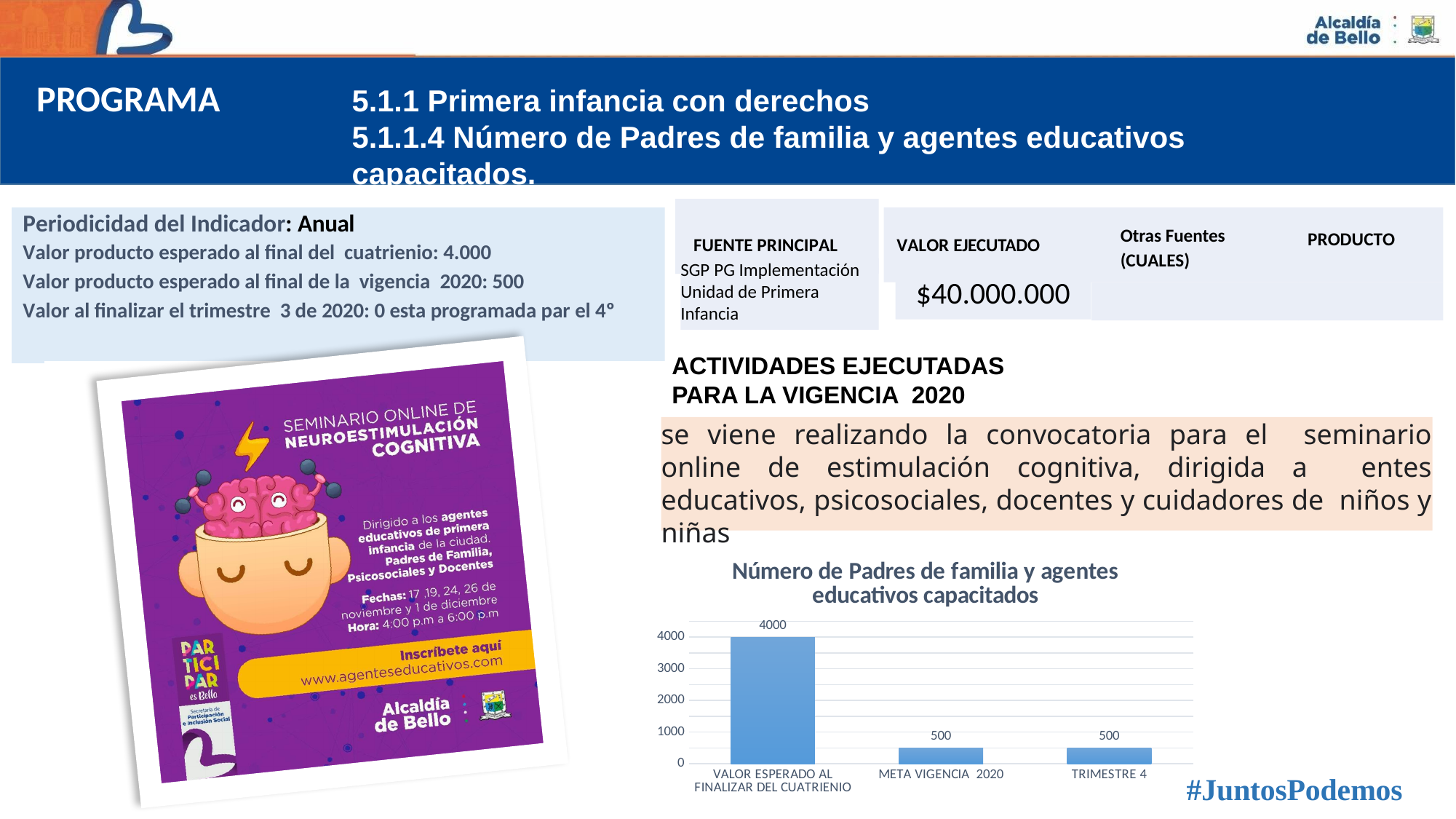
What is the value for TRIMESTRE 4? 500 What is the value for META VIGENCIA 2020? 500 Which is larger, the value for VALOR ESPERADO AL FINALIZAR DEL CUATRIENIO or the value for TRIMESTRE 4? VALOR ESPERADO AL FINALIZAR DEL CUATRIENIO Is the value for VALOR ESPERADO AL FINALIZAR DEL CUATRIENIO greater or less than 3000? greater How many categories are shown on the chart? 3 What kind of chart is shown on the slide? bar chart Is the value for META VIGENCIA 2020 greater or less than 1000? less What is the value for VALOR ESPERADO AL FINALIZAR DEL CUATRIENIO? 4000 What is the title of the chart? Número de Padres de familia y agentes educativos capacitados Which category has the highest value? VALOR ESPERADO AL FINALIZAR DEL CUATRIENIO What is the highest value shown on the chart's vertical axis? 4000 What is the difference between the value for VALOR ESPERADO AL FINALIZAR DEL CUATRIENIO and the value for META VIGENCIA 2020? 3500